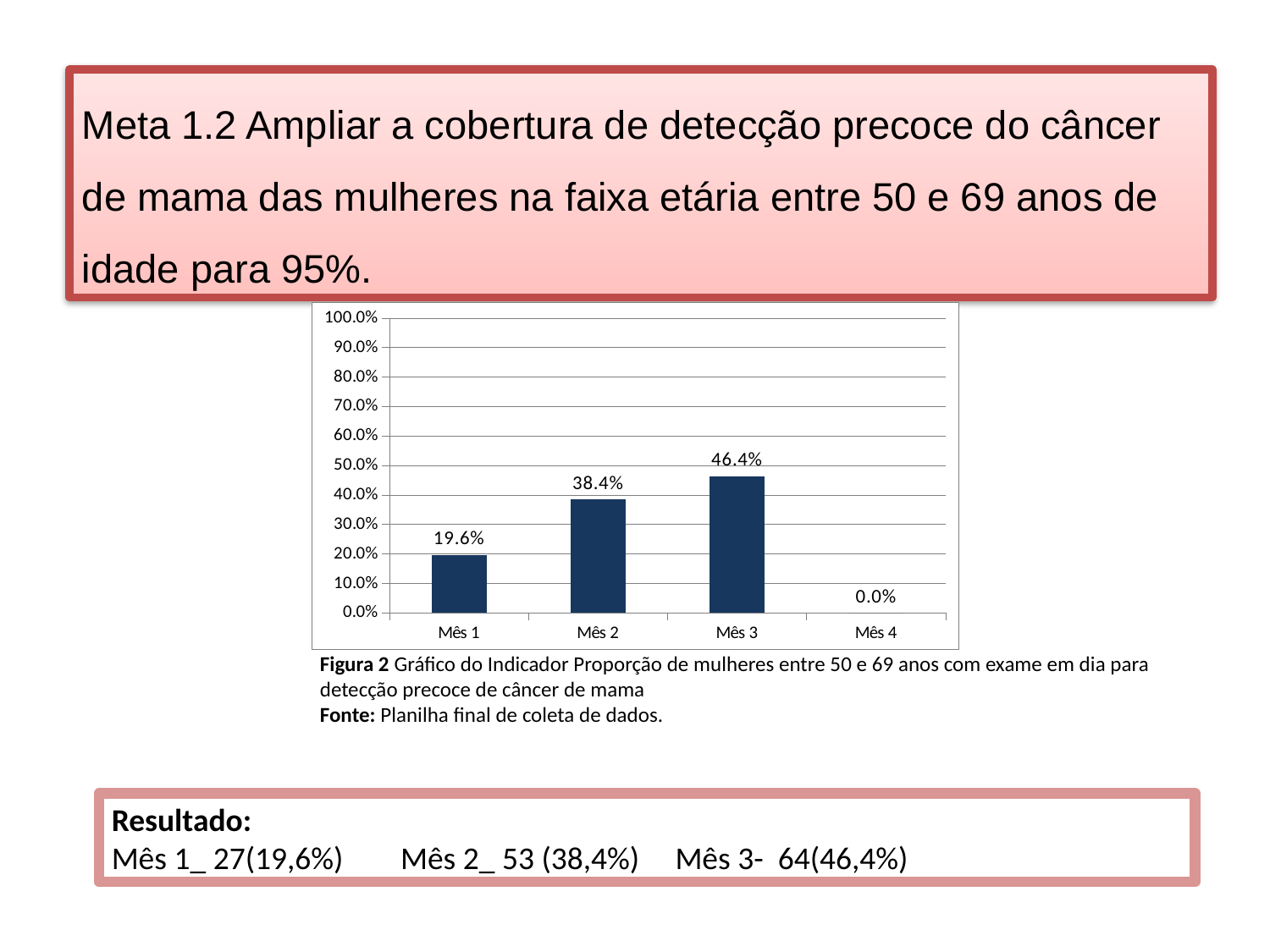
Which month has the lowest value? Mês 4 What is the value for Mês 3? 46.4% Do the values rise or fall from Mês 1 to Mês 3? Rise Which month has the highest value? Mês 3 What kind of chart is shown? Bar chart What is the value for Mês 2? 38.4% What is the difference between the values for Mês 3 and Mês 1? 26.8% Which is larger, the value for Mês 2 or the value for Mês 3? Mês 3 How many months are shown on the x axis? 4 What is the value for Mês 4? 0.0% What is the difference between the values for Mês 2 and Mês 1? 18.8% What is the value for Mês 1? 19.6%